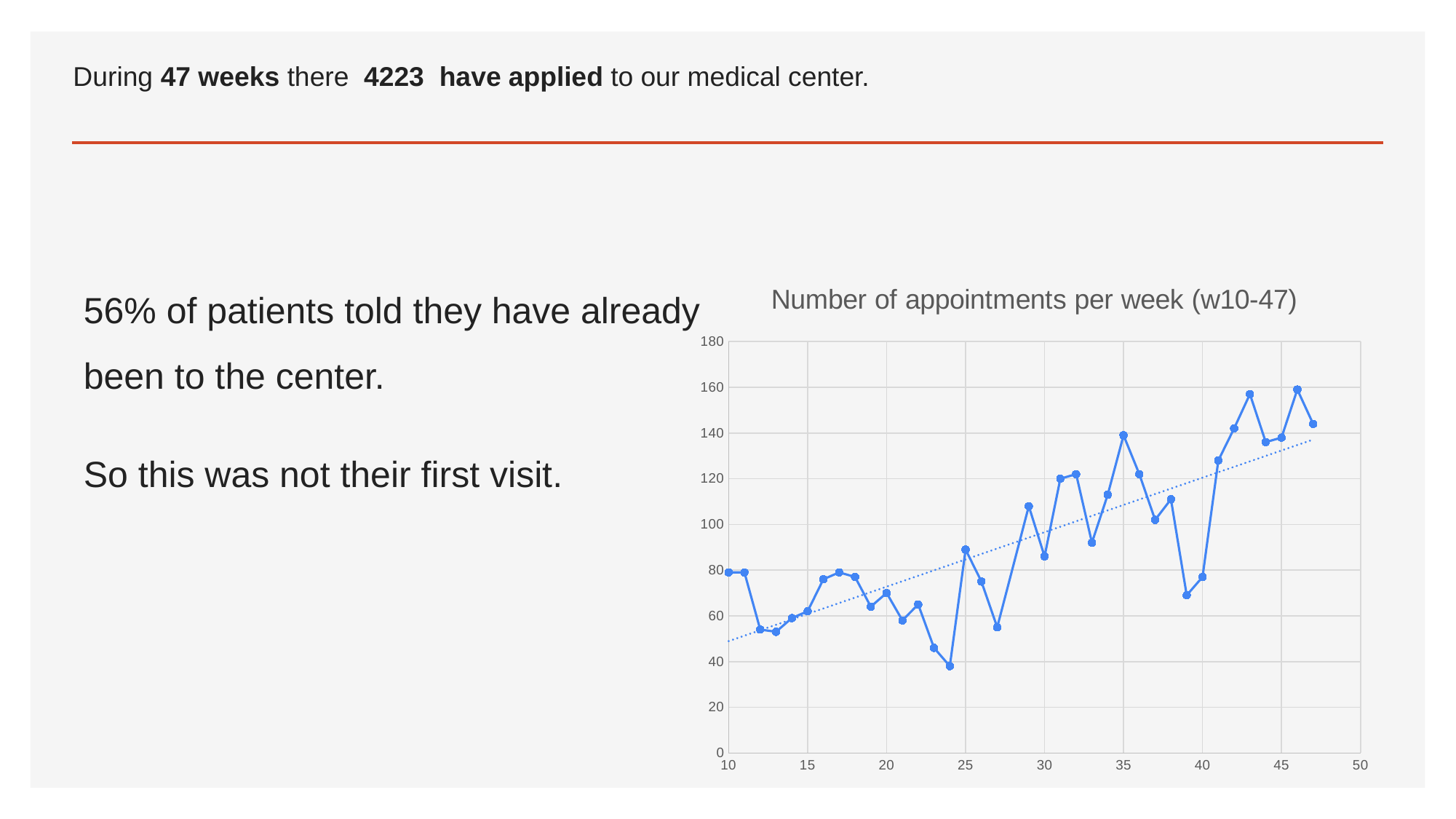
What kind of chart is shown on the slide? line chart What is the title of the chart? Number of appointments per week (w10-47) Is the value for week 46 greater or less than 140? greater Is the value for week 39 greater or less than 80? less Which week has the lowest number of appointments in the chart? 24 Is the value for week 35 greater or less than 120? greater Which week has more appointments, week 35 or week 39? week 35 Overall, do the number of appointments rise or fall from week 10 to week 47? rise What does the dotted line on the chart represent? a trendline Which week has more appointments, week 24 or week 29? week 29